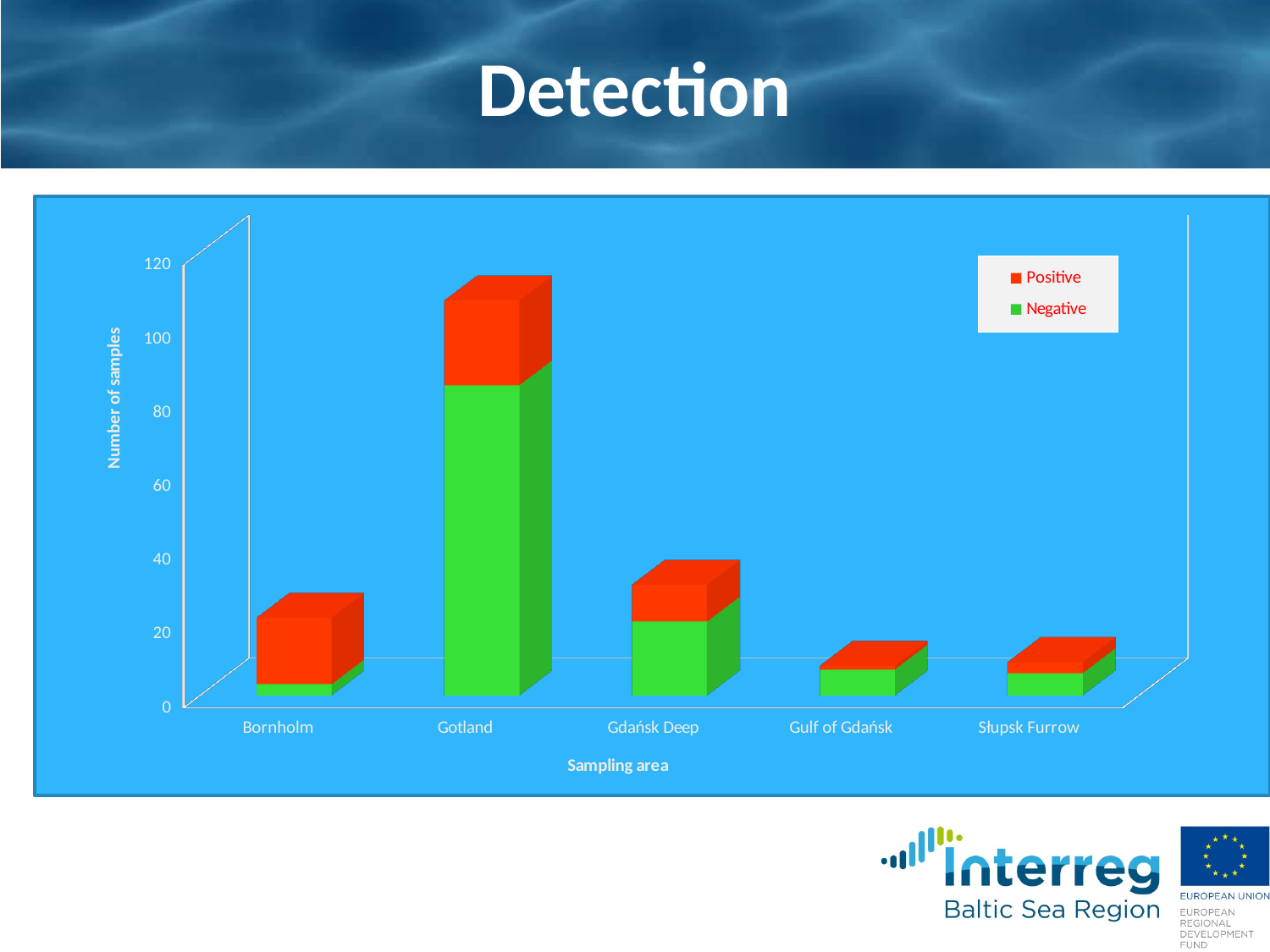
Which sampling area has the highest total number of samples? Gotland Is the Negative value for Gotland greater or less than 60? greater What kind of chart is shown on the slide? bar chart Is the total number of samples for Bornholm greater or less than 40? less Which has a larger total number of samples, Gotland or Gdańsk Deep? Gotland Is the total number of samples for Gotland greater or less than 100? greater How many sampling areas are shown on the x axis of the chart? 5 How many series does the chart legend list? 2 Which series is shown in red in the chart legend? Positive What is the title of the vertical axis of the chart? Number of samples